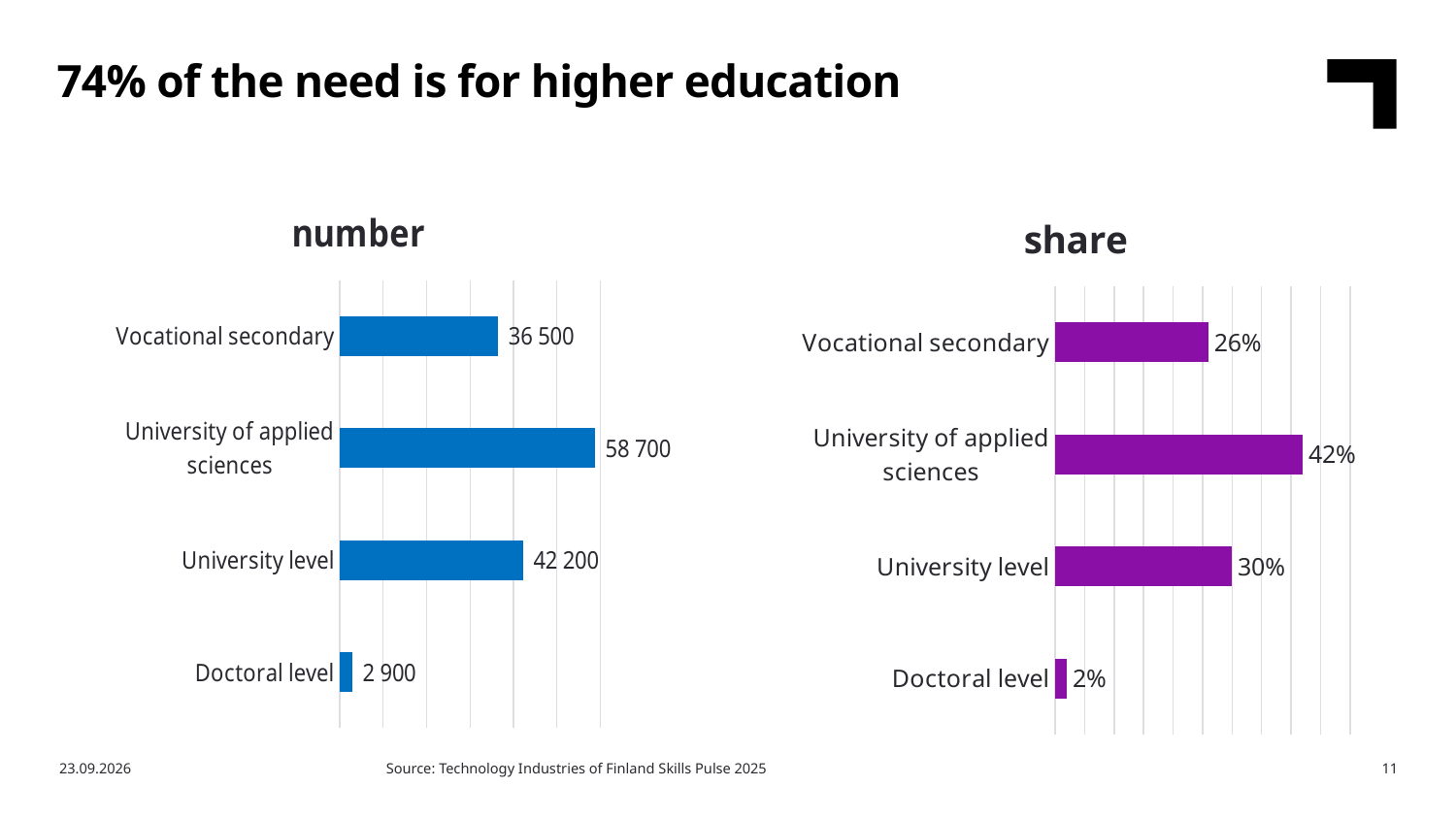
What kind of chart is the "number" chart? Bar chart How many categories does the "share" chart show? 4 In the "number" chart, what is the value for University of applied sciences? 58 700 In the "share" chart, what is the difference between University of applied sciences and Vocational secondary? 16% In the "number" chart, what is the value for Doctoral level? 2 900 In the "share" chart, which category has the lowest value? Doctoral level In the "number" chart, what is the difference between University of applied sciences and University level? 16 500 In the "share" chart, what is the value for University level? 30% In the "share" chart, what is the value for Vocational secondary? 26% What colour are the bars in the "share" chart? Purple In the "number" chart, which category has the highest value? University of applied sciences In the "number" chart, which is larger: Vocational secondary or University level? University level